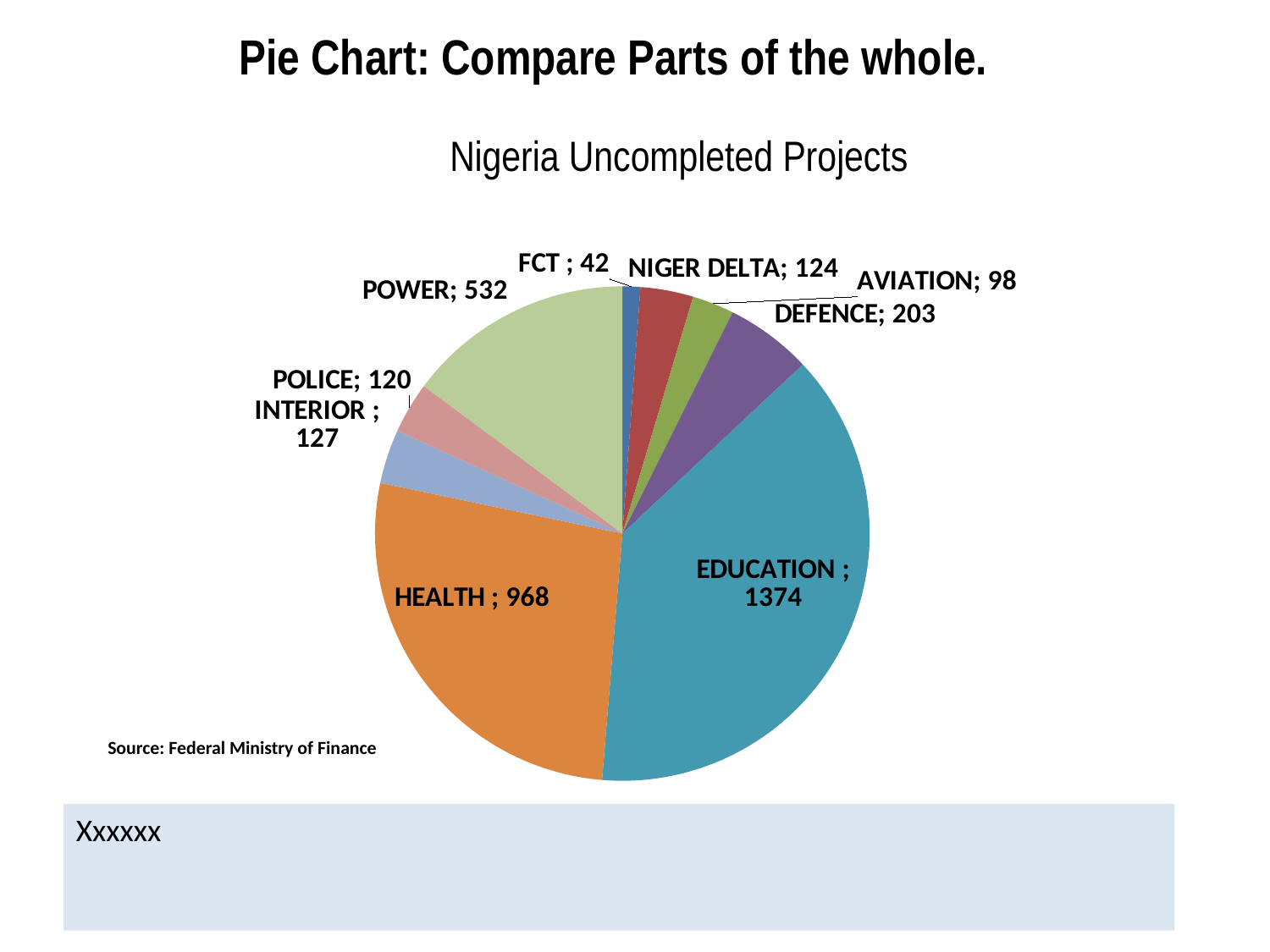
What is the difference between the values for NIGER DELTA and AVIATION? 26 What is the title of the chart? Nigeria Uncompleted Projects How many uncompleted projects are shown for POWER? 532 What source is cited for the chart data? Federal Ministry of Finance Which sector has the smallest slice of the pie? FCT What is the value shown for INTERIOR? 127 Which sector has the largest slice of the pie? EDUCATION What is the difference between the values for EDUCATION and HEALTH? 406 What type of chart is shown on the slide? Pie chart What is the value shown for DEFENCE? 203 How many sectors (slices) are shown in the pie chart? 9 Which is larger, the value for POWER or the value for DEFENCE? POWER